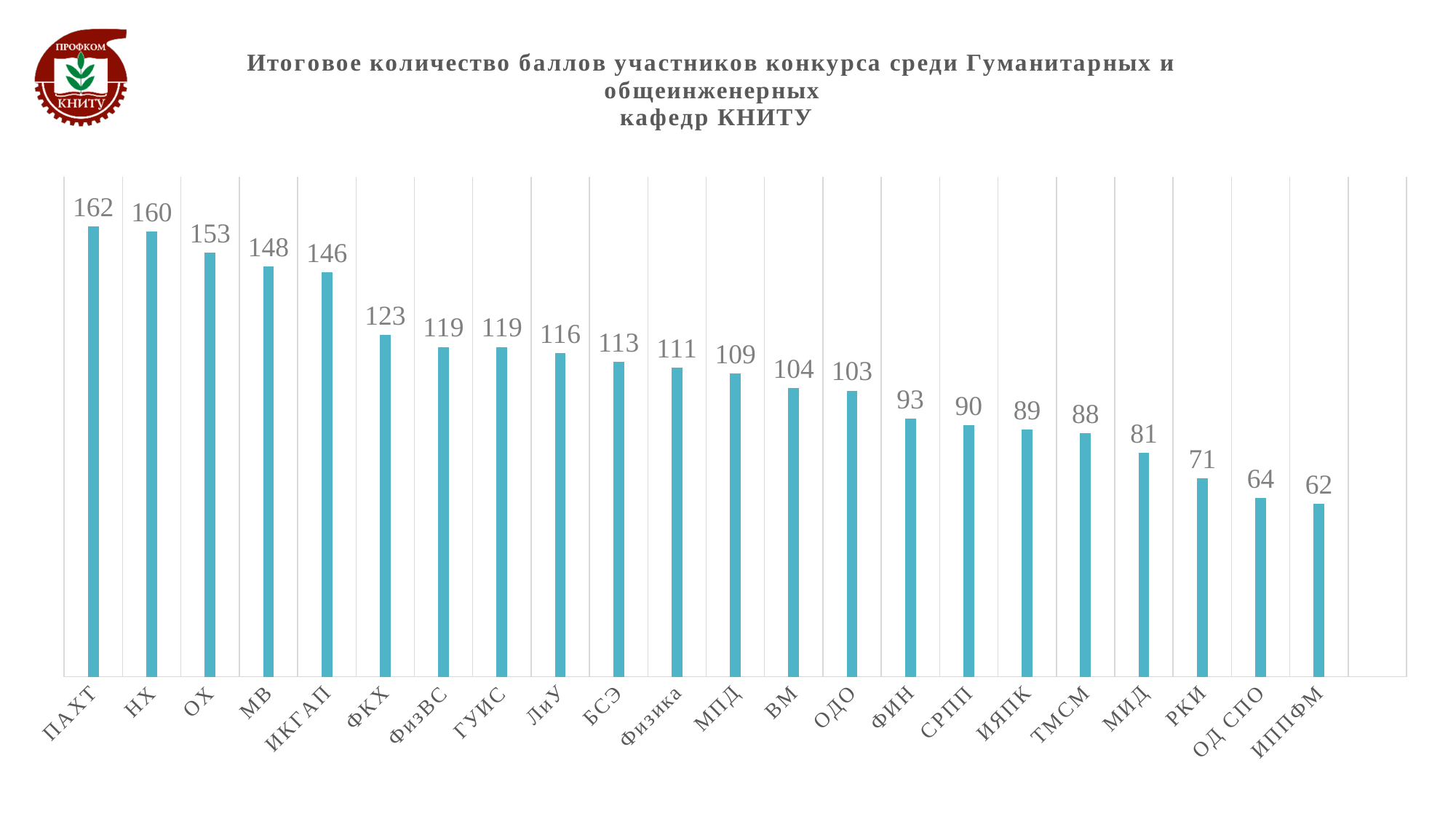
Which is larger, the value for ФИН or the value for МИД? ФИН What is the difference between the values for ОХ and МВ? 5 What is the value for ФКХ? 123 Which category has the lowest value? ИППФМ What kind of chart is this? bar chart What is the value for ОД СПО? 64 What is the value for ПАХТ? 162 What colour are the bars? teal (blue-green) What is the difference between the values for ПАХТ and ИППФМ? 100 Which category has the highest value? ПАХТ Do the values rise or fall from left to right along the x axis? fall How many categories are shown on the x axis? 22